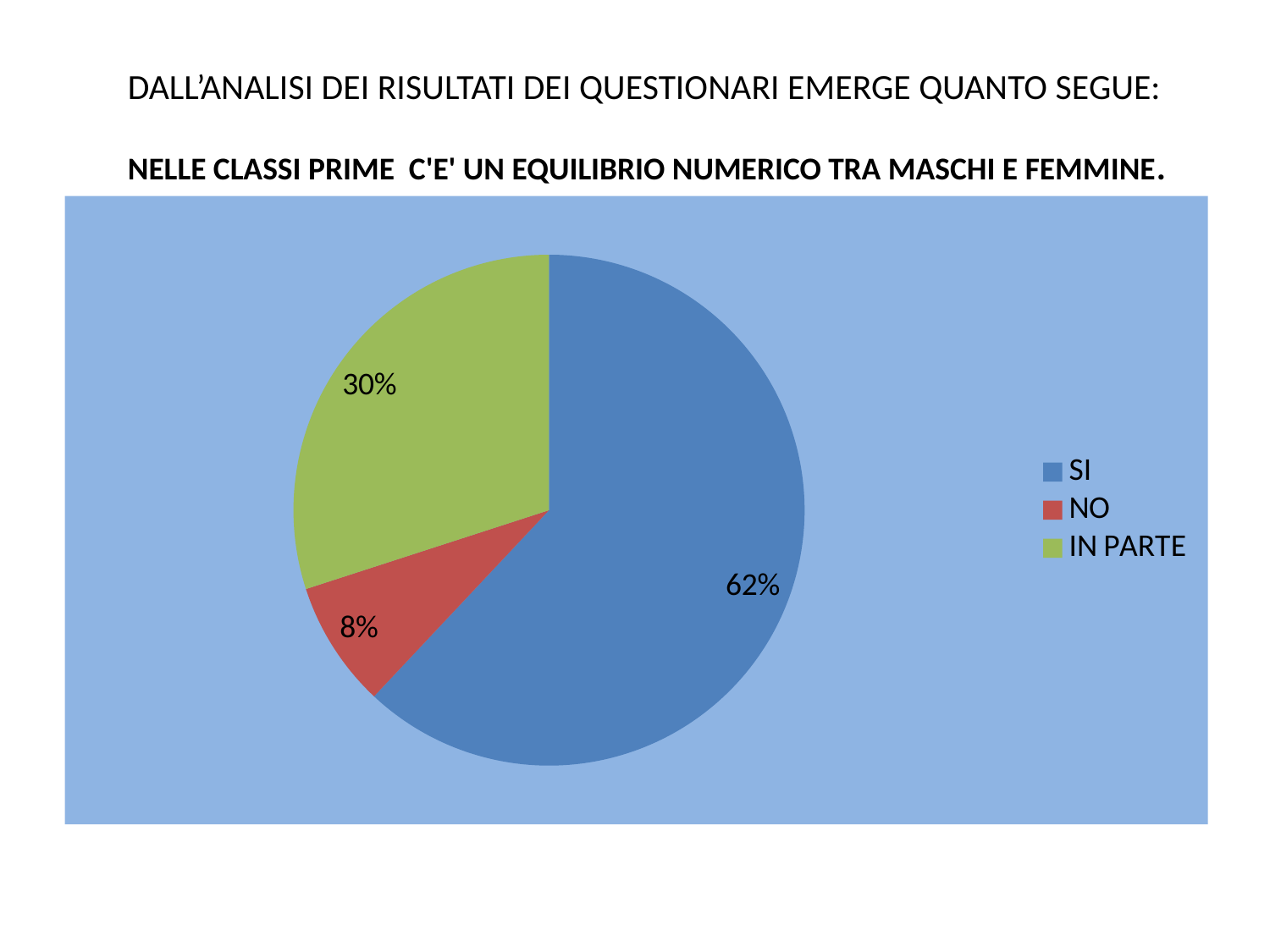
Which category has the smallest slice of the pie? NO Which slice is larger, NO or IN PARTE? IN PARTE What share of the pie does the NO slice represent? 8% Which category has the largest slice of the pie? SI What is the difference in percentage points between the SI slice and the IN PARTE slice? 32 What is the difference in percentage points between the IN PARTE slice and the NO slice? 22 What share of the pie does the IN PARTE slice represent? 30% What are the legend entries of the pie chart? SI, NO, IN PARTE What kind of chart is shown on the slide? pie chart What colour is the IN PARTE slice? green How many categories does the pie chart show? 3 What share of the pie does the SI slice represent? 62%